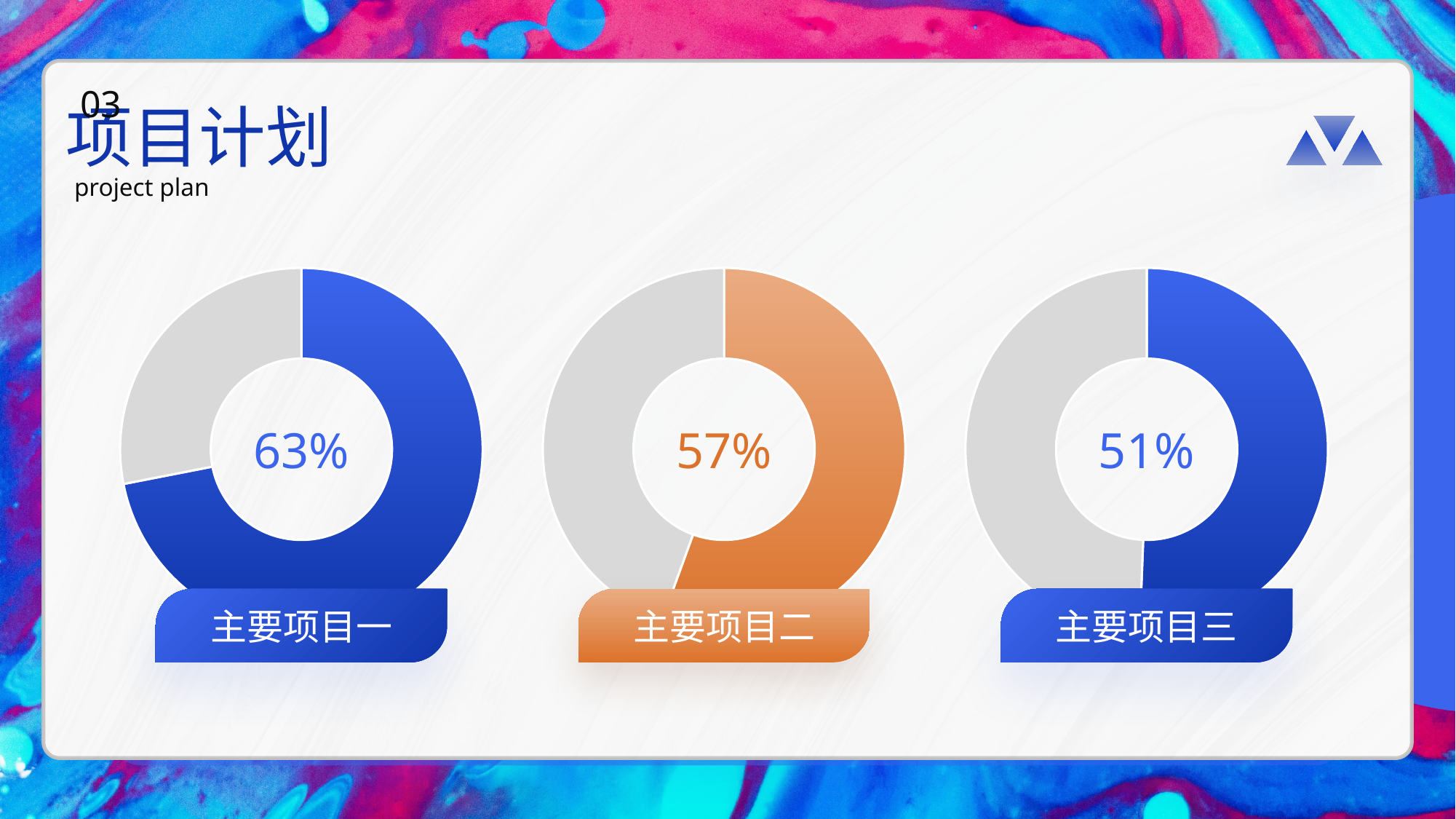
How many donut charts are shown on the slide? 3 Which of the three donut charts uses an orange colour for its filled portion? 主要项目二 Which is larger: the percentage in the 主要项目一 chart or the percentage in the 主要项目二 chart? 主要项目一 What is the difference between the percentage in the 主要项目二 chart and the percentage in the 主要项目三 chart? 6% Across the three donut charts, which project has the highest percentage? 主要项目一 In the 主要项目一 donut chart, what percentage is shown in the centre? 63% What kind of chart is used for 主要项目一? Donut chart In the 主要项目三 donut chart, what share of the ring is filled in blue? 51% Across the three donut charts, which project has the lowest percentage? 主要项目三 In the 主要项目二 donut chart, what percentage is shown in the centre? 57% What is the difference between the percentage in the 主要项目一 chart and the percentage in the 主要项目三 chart? 12% In the 主要项目三 donut chart, what percentage is shown in the centre? 51%